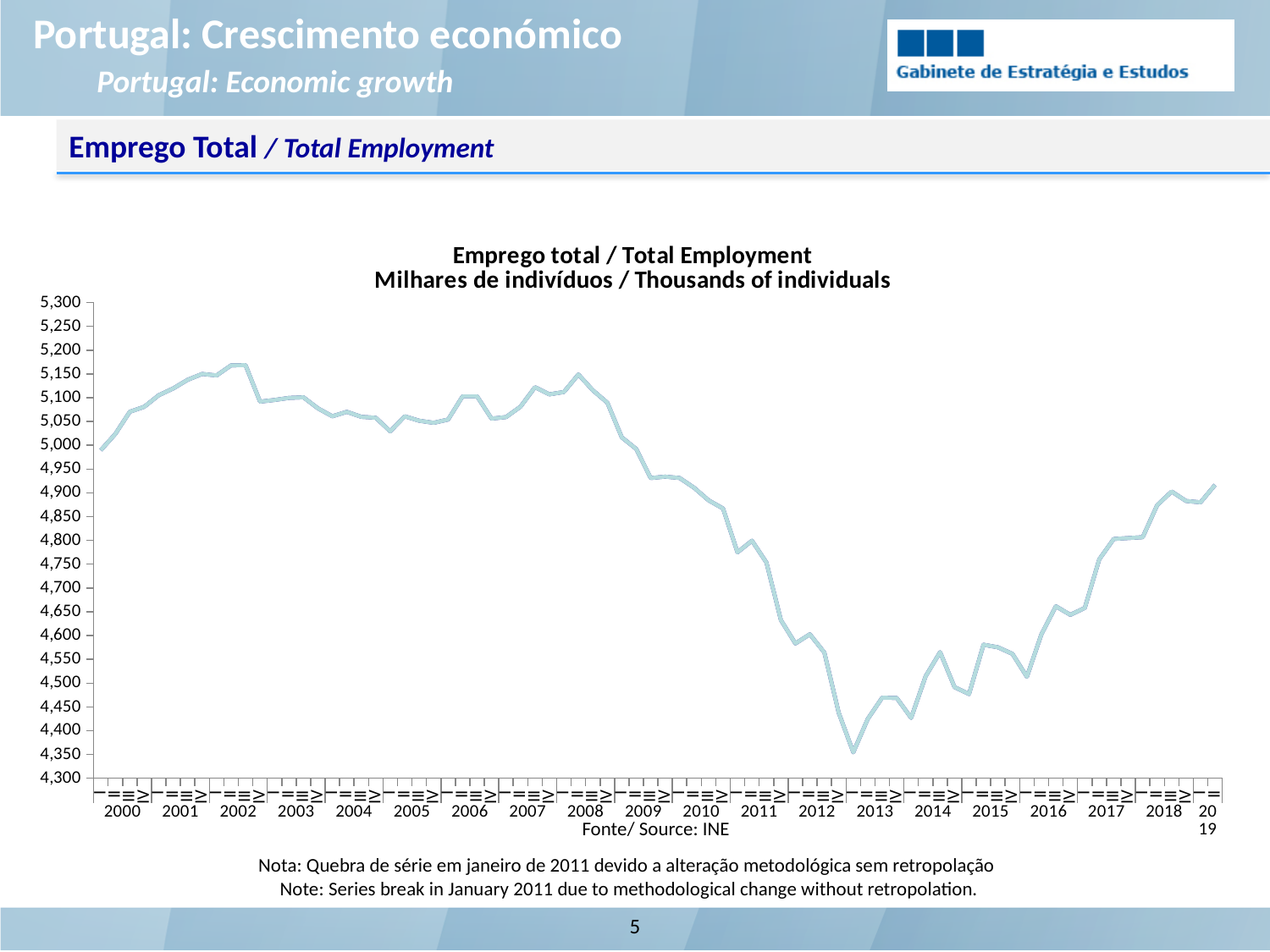
How many years are labelled on the x axis? 20 Is the lowest value of the series greater or less than 4,400? less Does the series rise or fall between 2008 and 2013? fall Which is higher, the value in 2005 or the value in 2012? 2005 Does the series rise or fall between 2013 and 2019? rise In which year does the series reach its lowest point? 2013 What kind of chart is shown on the slide? line chart What is the title of the chart? Emprego total / Total Employment Milhares de indivíduos / Thousands of individuals Is the value at the start of 2000 greater or less than 5,100? less Is the peak value reached in 2002 greater or less than 5,100? greater What is the source of the data cited below the chart? INE